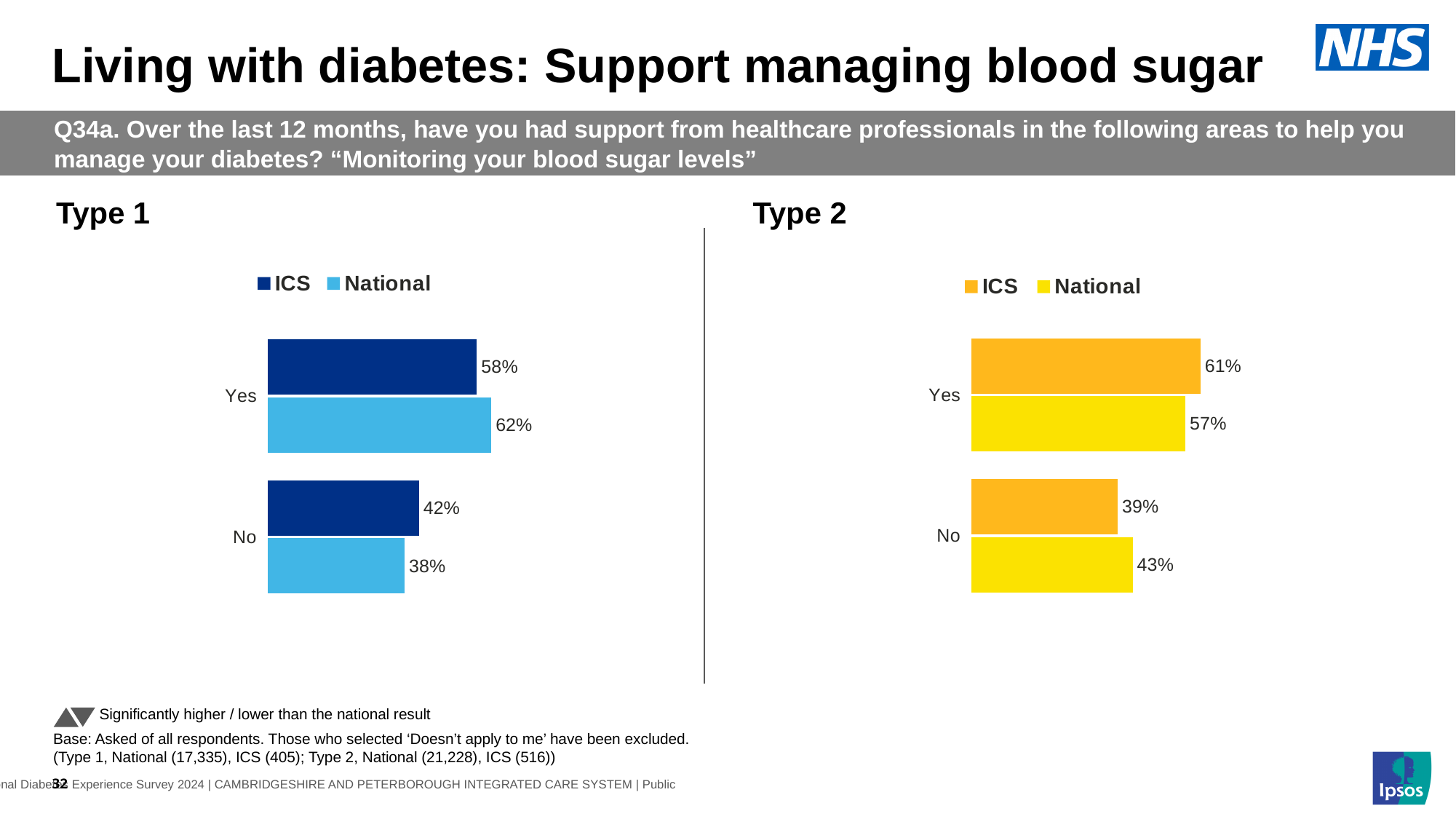
In the Type 1 chart, what is the National value for No? 38% In the Type 1 chart, what is the difference between the National and ICS values for Yes? 4 percentage points In the Type 2 chart, which bar has the lowest value? ICS No (39%) In the Type 1 chart, what is the ICS value for Yes? 58% In the Type 2 chart, what is the National value for No? 43% In the Type 1 chart, which series has the highest value overall? National (Yes, 62%) How many series does the legend of the Type 2 chart list? 2 In the Type 1 chart, which is larger for No: ICS or National? ICS In the Type 2 chart, which is larger for Yes: ICS or National? ICS What kind of chart is the Type 1 chart? Bar chart In the Type 2 chart, what is the difference between the National and ICS values for No? 4 percentage points In the Type 2 chart, what is the ICS value for Yes? 61%